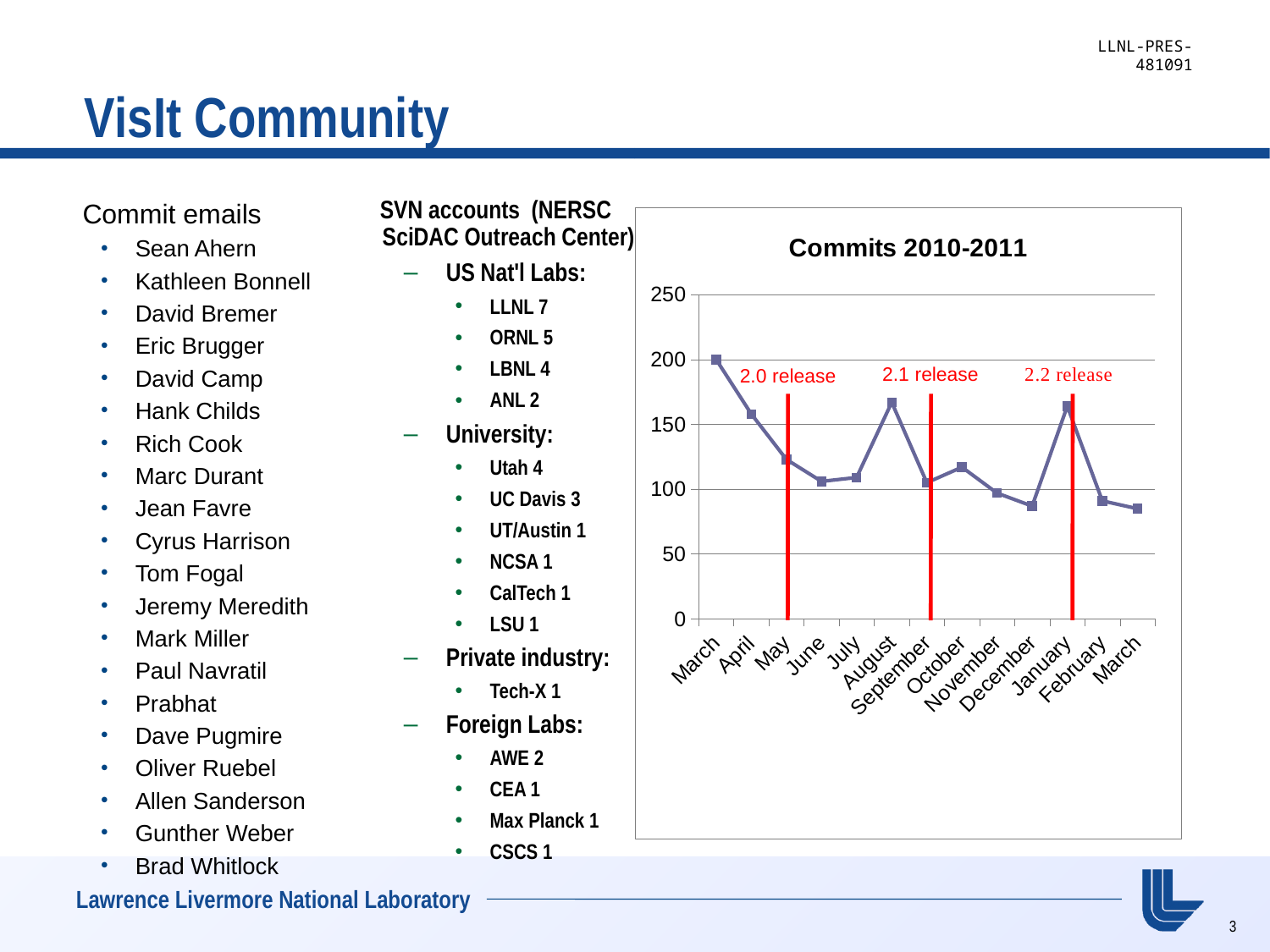
Is the value for January greater or less than 150? greater How many monthly data points are plotted on the chart? 13 What kind of chart is shown on the slide? line chart Is the value for December greater or less than 100? less Which has more commits, August or September? August Is the value for August greater or less than 150? greater How many release markers (red vertical lines) are drawn on the chart? 3 What is the title of the chart? Commits 2010-2011 Which has more commits, January or February? January Which month has the highest number of commits on the chart? March (the first point) Do the commits rise or fall from the first March through June? fall